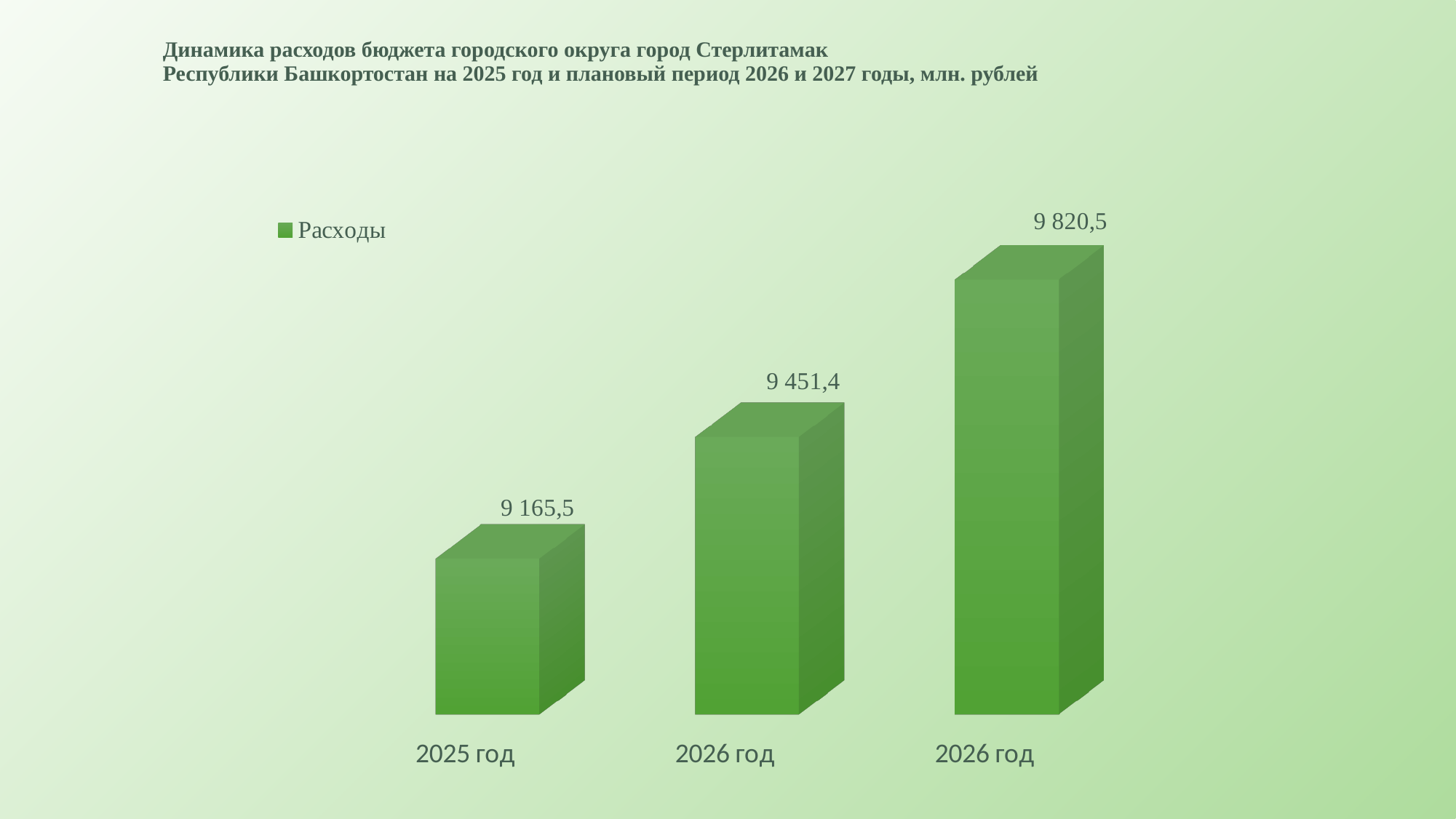
What is the value of the middle bar? 9 451,4 What is the value of the rightmost bar? 9 820,5 How many bars are shown in the chart? 3 What is the difference between the middle bar and the 2025 год bar? 285,9 Which is larger, the value for 2025 год or the value of the middle bar? the middle bar Which category has the lowest value? 2025 год Which bar has the highest value? the rightmost bar (9 820,5) What kind of chart is shown on the slide? bar chart What is the difference between the rightmost bar and the 2025 год bar? 655,0 What is the difference between the rightmost bar and the middle bar? 369,1 How many series does the legend list? 1 What is the value of the bar for 2025 год? 9 165,5